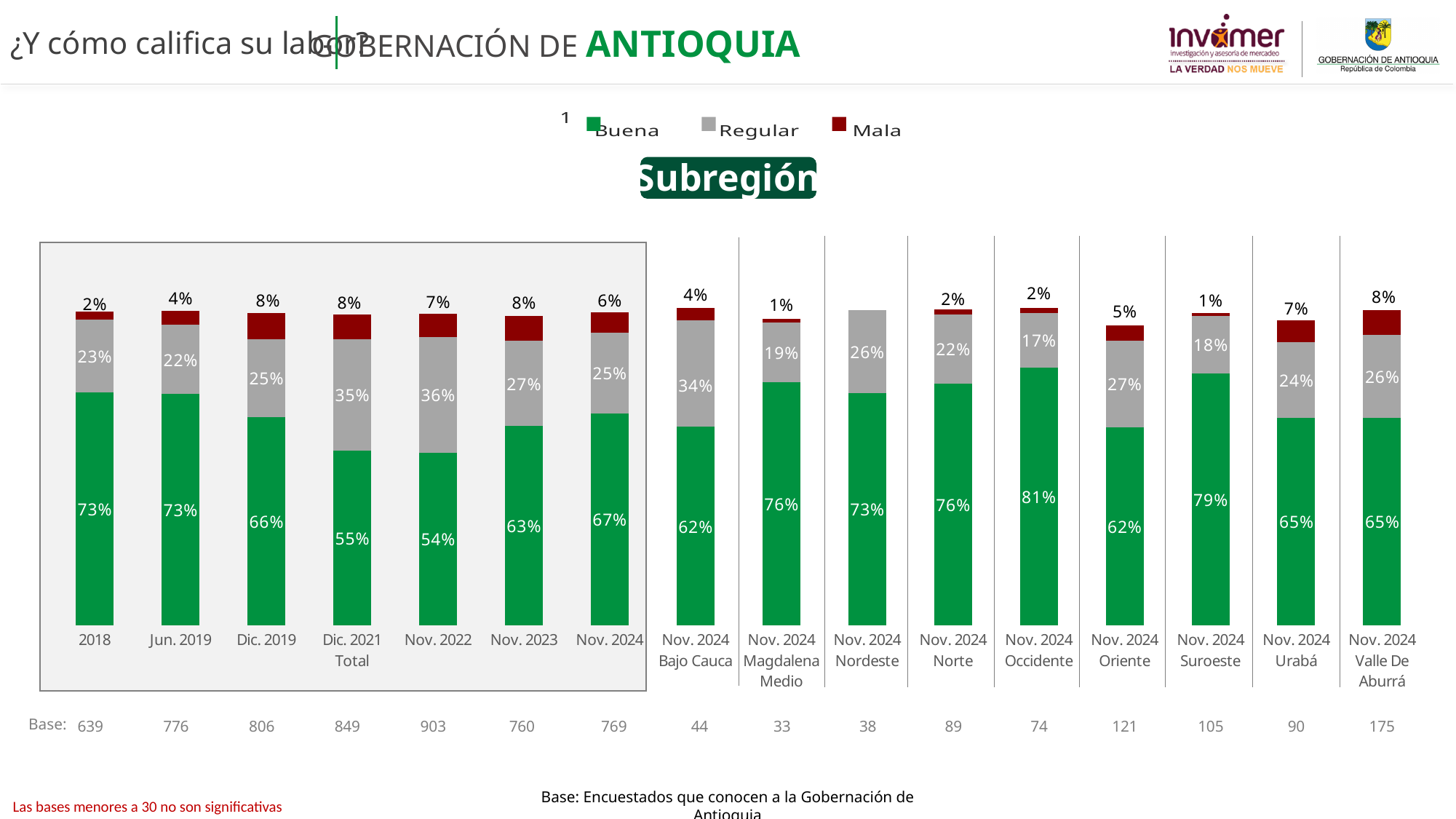
What is the Regular value for Dic. 2021? 35% Which has a larger Buena value: Nov. 2024 Suroeste or Nov. 2024 Urabá? Nov. 2024 Suroeste How many series does the legend list? 3 What is the Mala value for Nov. 2024 Valle De Aburrá? 8% Which category has the lowest Buena value? Nov. 2022 Which category has the highest Buena value? Nov. 2024 Occidente What is the Buena value for Nov. 2024 Occidente? 81% What is the total of the stacked bar for Nov. 2024 Occidente (Buena + Regular + Mala)? 100% What type of chart is shown on the slide? Stacked bar chart How many bars (categories) are plotted in the chart? 16 What is the difference between the Buena value for Nov. 2024 (Total) and Nov. 2023? 4 percentage points Which category has the highest Regular value? Nov. 2022